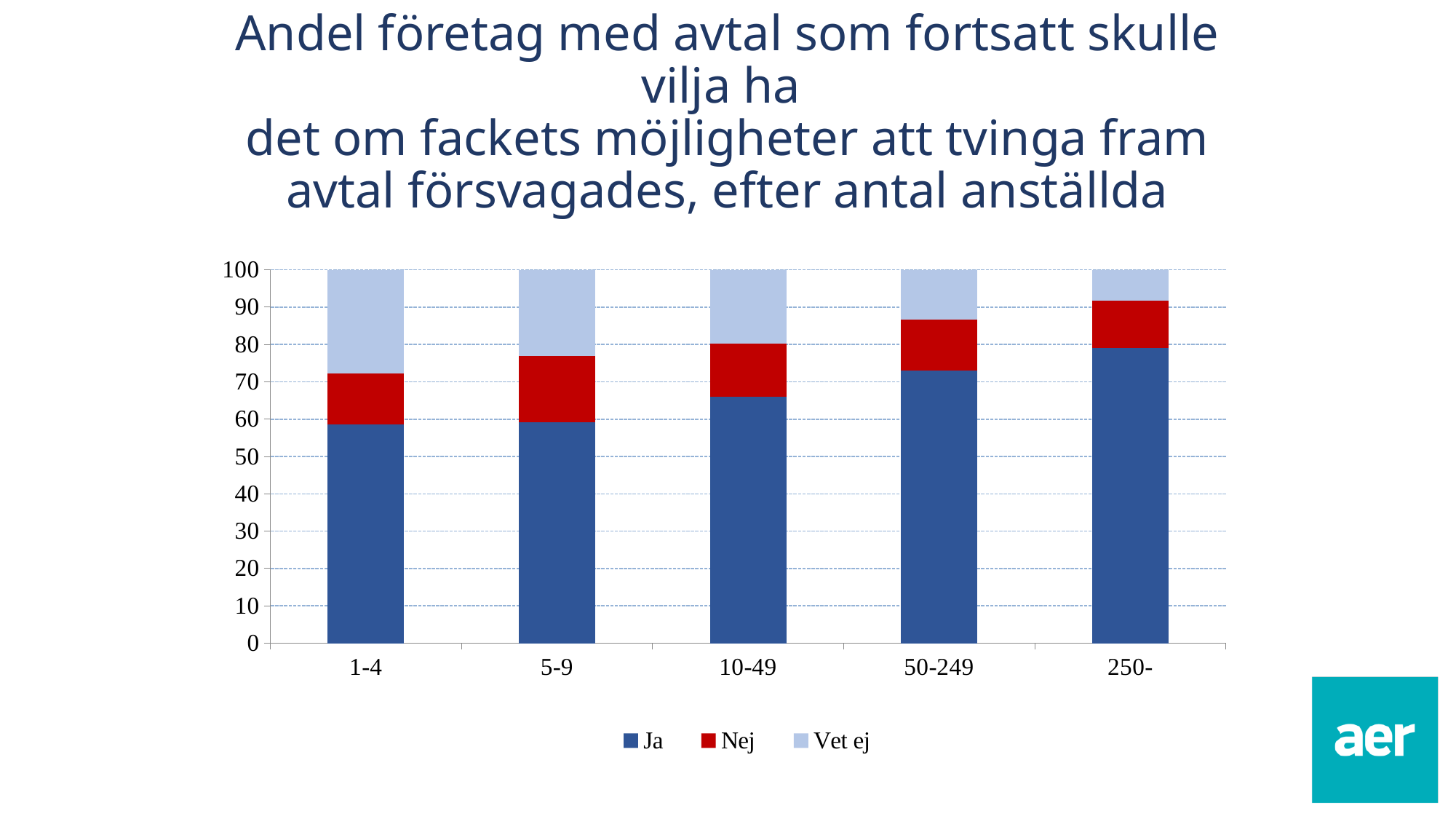
Does the Ja share rise or fall as company size increases along the x axis? Rises Which category has the largest Vet ej segment? 1-4 What is the total height of the stacked bar for the 5-9 category? 100 Which category has the highest value for Ja? 250- How many series does the legend list? 3 How many employee-size categories are shown on the x axis? 5 Is the value for Ja in the 250- category greater or less than 70? greater Which series are listed in the legend? Ja, Nej, Vet ej Which is larger, the Ja value for 10-49 or for 50-249? 50-249 Which category has the smallest Vet ej segment? 250- What kind of chart is shown on the slide? Stacked bar chart Is the value for Ja in the 1-4 category greater or less than 60? less